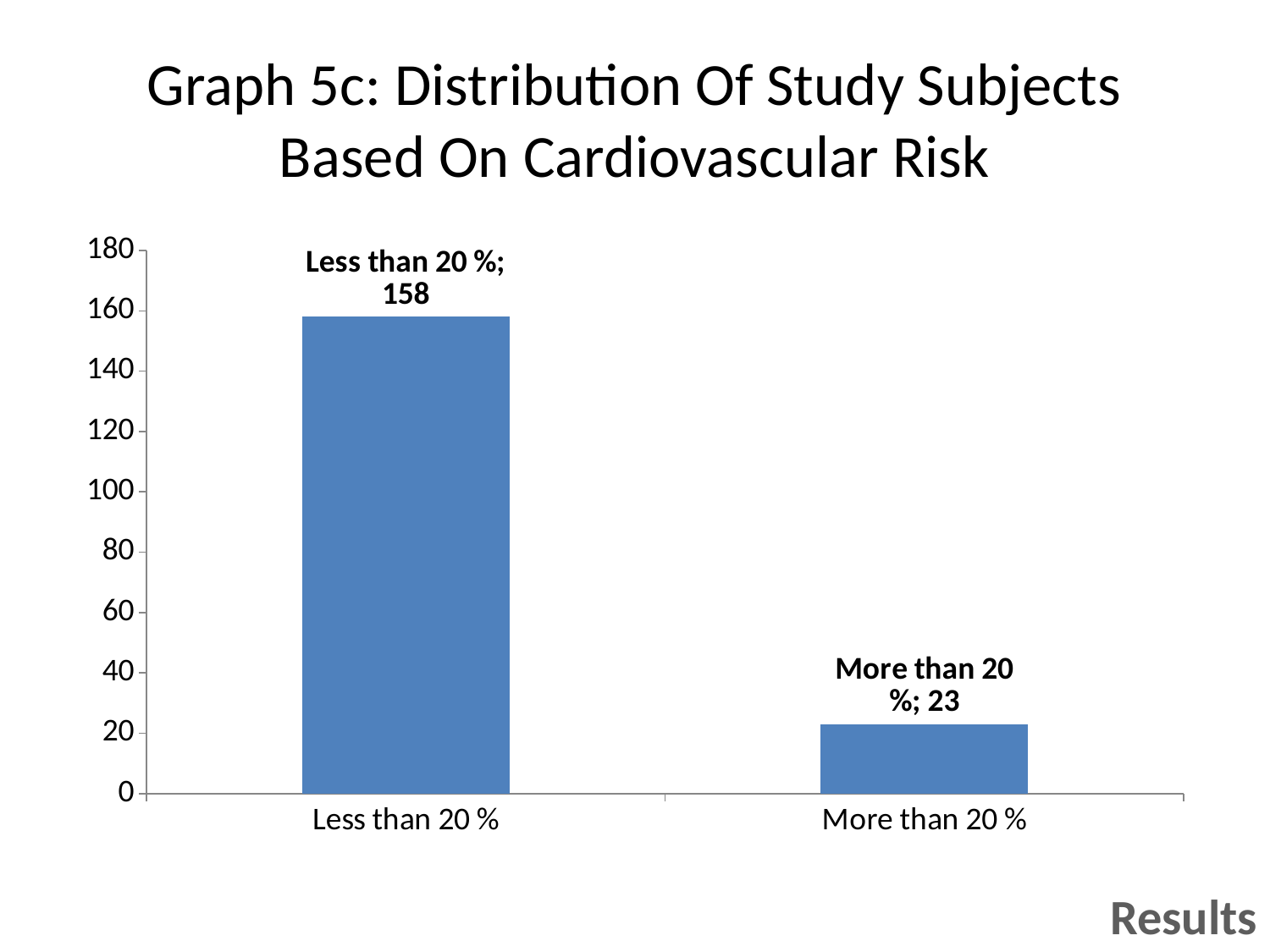
How many categories are shown in the chart? 2 What kind of chart is shown on the slide? Bar chart Which is larger, the value for 'Less than 20 %' or 'More than 20 %'? Less than 20 % What is the total of the two values shown in the chart? 181 What is the value for the 'Less than 20 %' category? 158 Which category has the lowest value? More than 20 % Is the value for 'More than 20 %' greater or less than 40? less What is the difference between the values for 'Less than 20 %' and 'More than 20 %'? 135 Which category has the highest value? Less than 20 % Is the value for 'Less than 20 %' greater or less than 140? greater What is the title of the chart? Graph 5c: Distribution Of Study Subjects Based On Cardiovascular Risk What is the value for the 'More than 20 %' category? 23